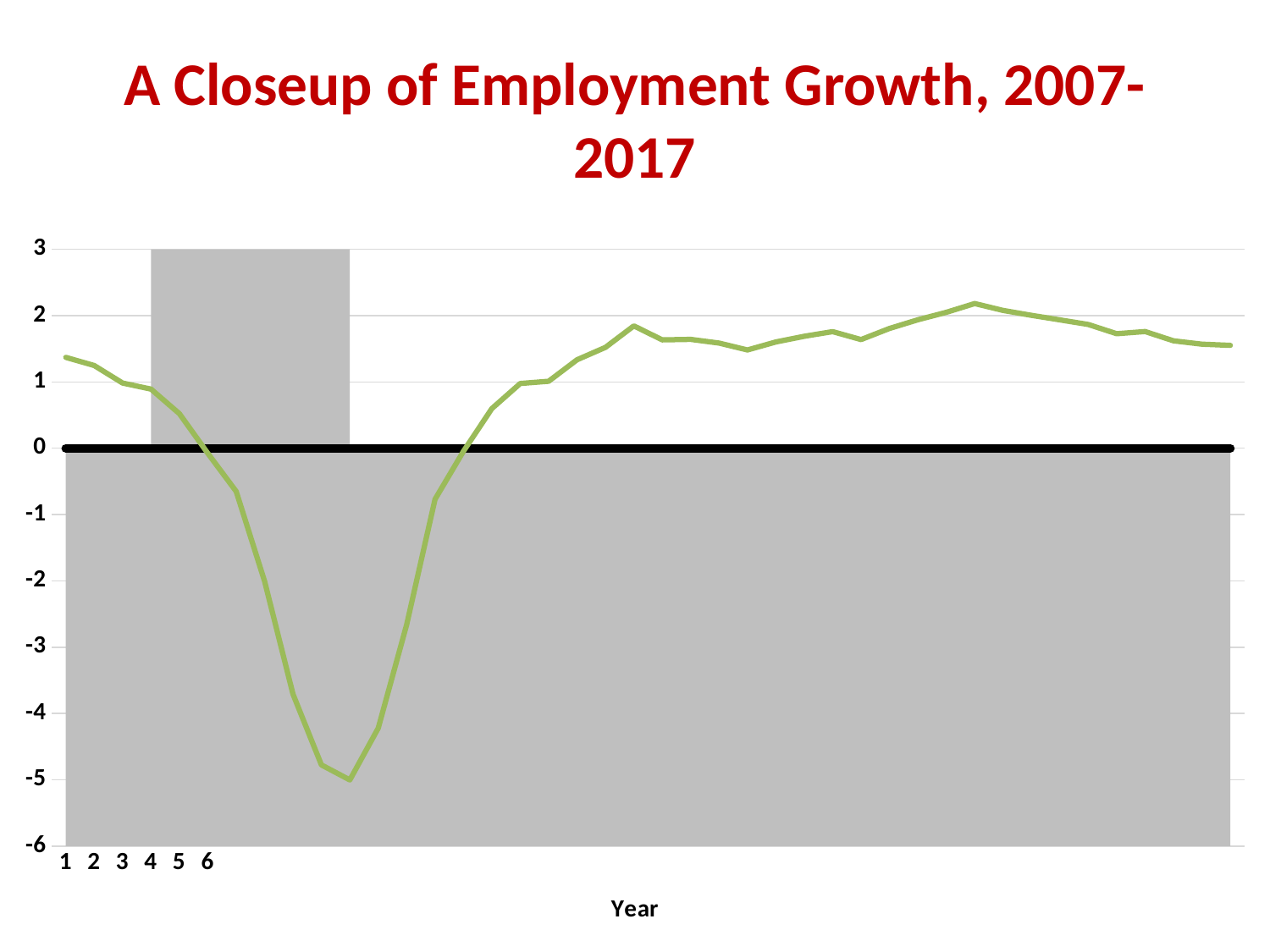
Does the line rise or fall from its lowest point to the point where it crosses back above 0? rise Is the value of the line at year 3 greater or less than 0? greater What is the lowest value shown on the y axis of the chart? -6 Is the lowest value reached by the line greater or less than -4? less What is the label on the x axis of the chart? Year Is the value of the line at the far right end of the chart greater or less than 2? less Does the line rise or fall between year 1 and its lowest point? fall What is the title of the chart on the slide? A Closeup of Employment Growth, 2007-2017 What kind of chart is shown on the slide? line chart